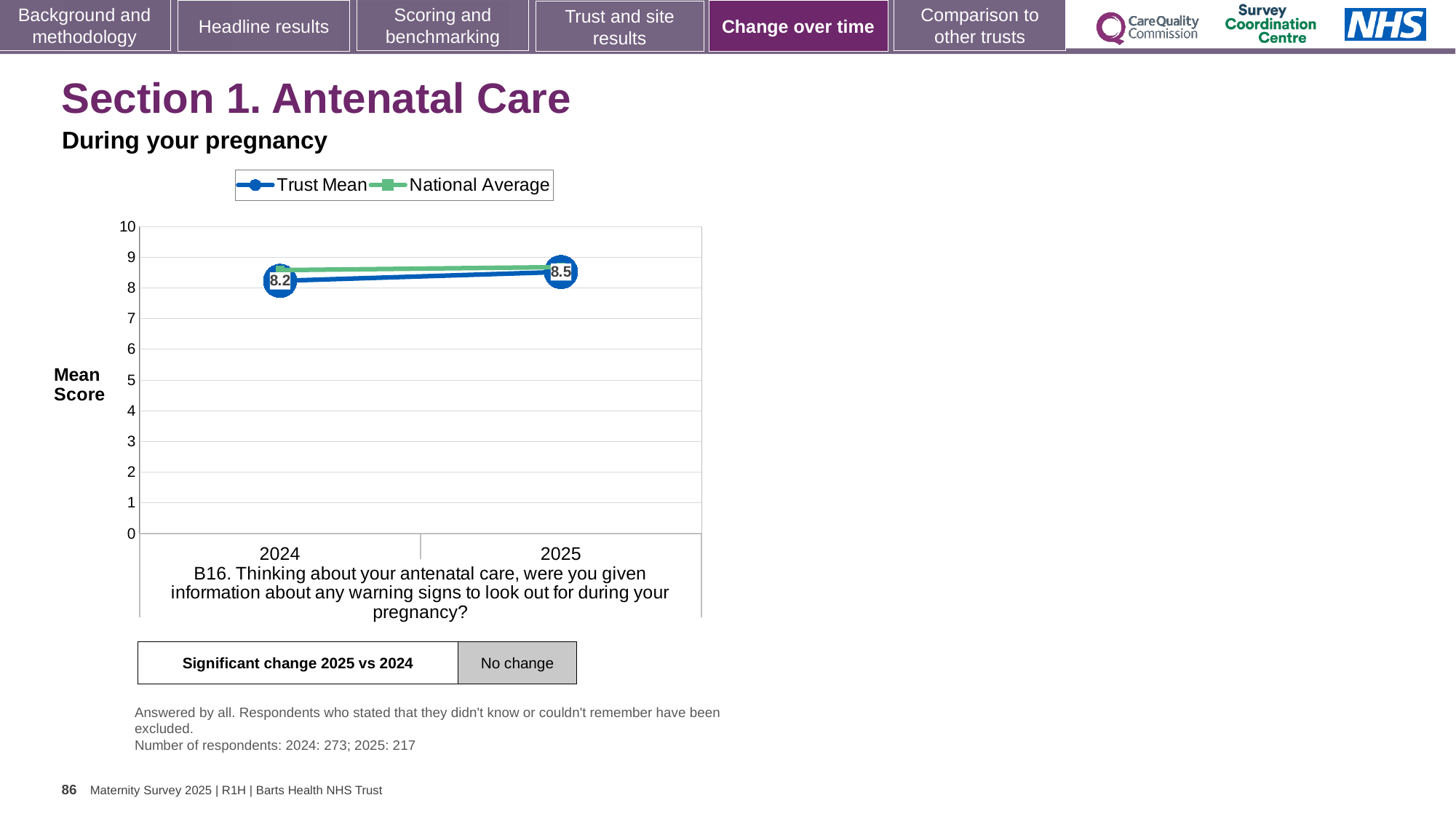
By how much did the Trust Mean change from 2024 to 2025? 0.3 What is the Trust Mean value for 2024? 8.2 What is the label on the y axis of the chart? Mean Score What is the Trust Mean value for 2025? 8.5 How many years are plotted on the x axis? 2 How many series does the legend list? 2 In which year is the Trust Mean at its highest? 2025 Does the Trust Mean rise or fall from 2024 to 2025? rise Is the National Average value for 2024 greater or less than 8? greater Which year has the higher Trust Mean, 2024 or 2025? 2025 In which year is the Trust Mean at its lowest? 2024 What kind of chart is shown on the slide? line chart